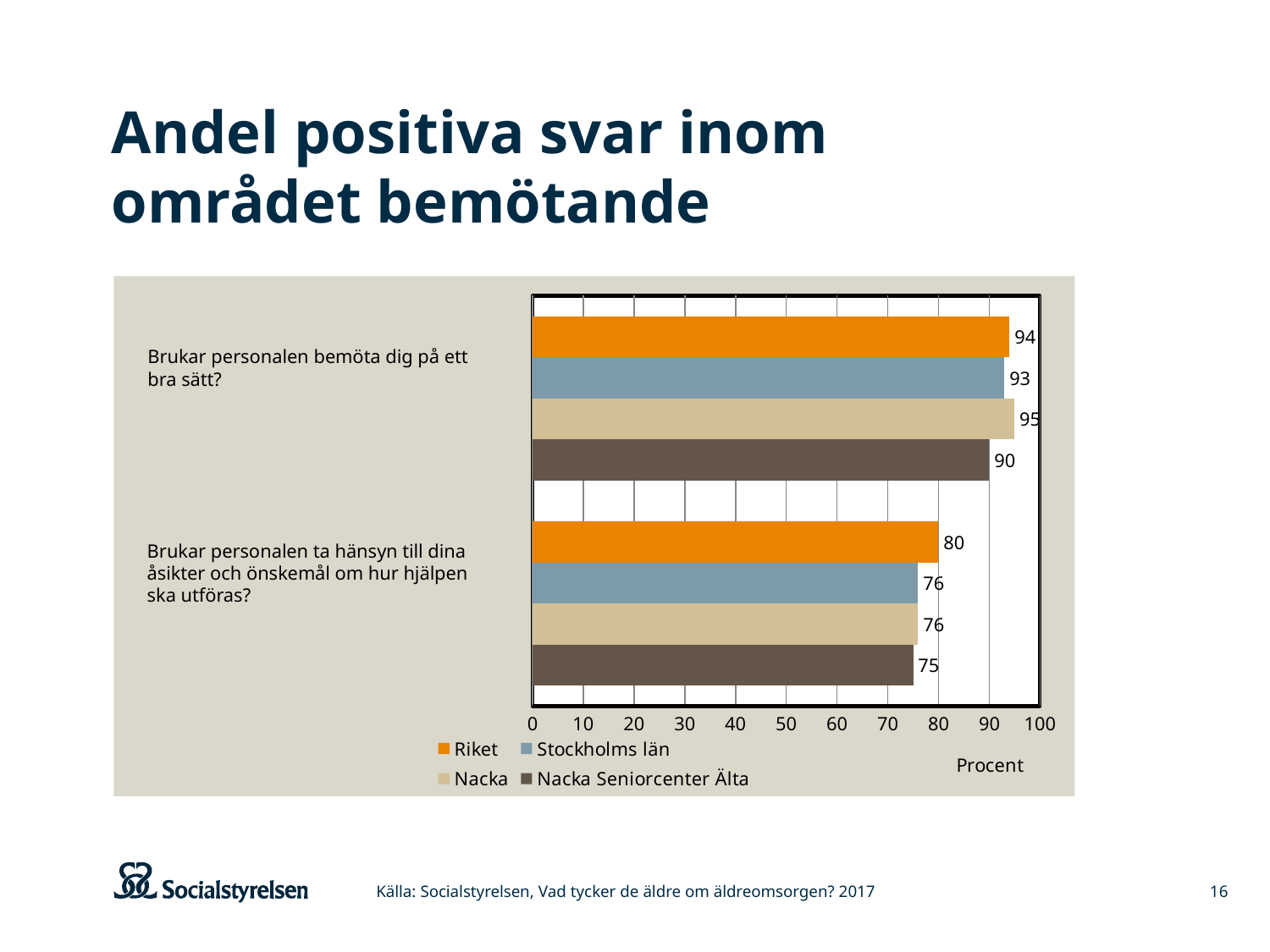
How many questions (categories) are shown on the chart? 2 Which is larger for Nacka: the value for "Brukar personalen bemöta dig på ett bra sätt?" or the value for "Brukar personalen ta hänsyn till dina åsikter och önskemål om hur hjälpen ska utföras?"? Brukar personalen bemöta dig på ett bra sätt? What is the label on the horizontal axis of the chart? Procent Which series has the highest value on the question "Brukar personalen bemöta dig på ett bra sätt?"? Nacka Is the value for Nacka Seniorcenter Älta on the question "Brukar personalen bemöta dig på ett bra sätt?" greater or less than 80? greater What is the value for Riket on the question "Brukar personalen bemöta dig på ett bra sätt?"? 94 Which series has the lowest value on the question "Brukar personalen ta hänsyn till dina åsikter och önskemål om hur hjälpen ska utföras?"? Nacka Seniorcenter Älta What is the value for Nacka Seniorcenter Älta on the question "Brukar personalen ta hänsyn till dina åsikter och önskemål om hur hjälpen ska utföras?"? 75 What kind of chart is shown on the slide? Bar chart What is the value for Stockholms län on the question "Brukar personalen bemöta dig på ett bra sätt?"? 93 What is the difference between the Riket value and the Nacka Seniorcenter Älta value on the question "Brukar personalen ta hänsyn till dina åsikter och önskemål om hur hjälpen ska utföras?"? 5 How many series does the legend list? 4